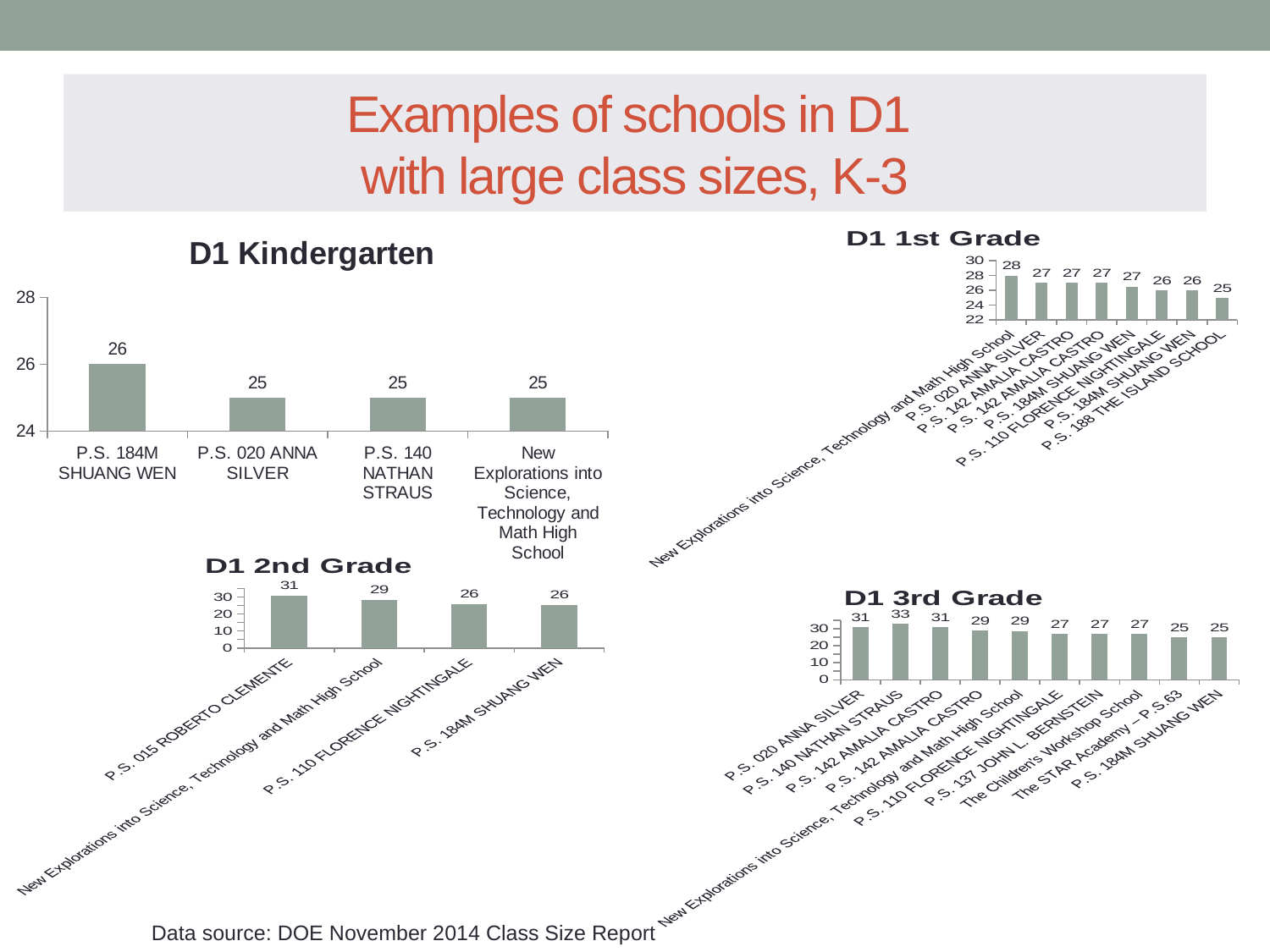
In the D1 3rd Grade chart, what is the value for P.S. 137 JOHN L. BERNSTEIN? 27 In the D1 Kindergarten chart, which school has the highest value? P.S. 184M SHUANG WEN In the D1 2nd Grade chart, what is the value for P.S. 015 ROBERTO CLEMENTE? 31 How many schools are shown in the D1 Kindergarten chart? 4 In the D1 1st Grade chart, which school has the highest value? New Explorations into Science, Technology and Math High School In the D1 Kindergarten chart, what is the value for P.S. 184M SHUANG WEN? 26 In the D1 3rd Grade chart, which school has the highest value? P.S. 140 NATHAN STRAUS In the D1 1st Grade chart, what is the difference between the value for New Explorations into Science, Technology and Math High School and the value for P.S. 188 THE ISLAND SCHOOL? 3 In the D1 2nd Grade chart, which is larger, the value for P.S. 015 ROBERTO CLEMENTE or the value for P.S. 110 FLORENCE NIGHTINGALE? P.S. 015 ROBERTO CLEMENTE How many schools are shown in the D1 3rd Grade chart? 10 In the D1 1st Grade chart, what is the value for P.S. 188 THE ISLAND SCHOOL? 25 What type of chart is the D1 2nd Grade chart? Bar chart